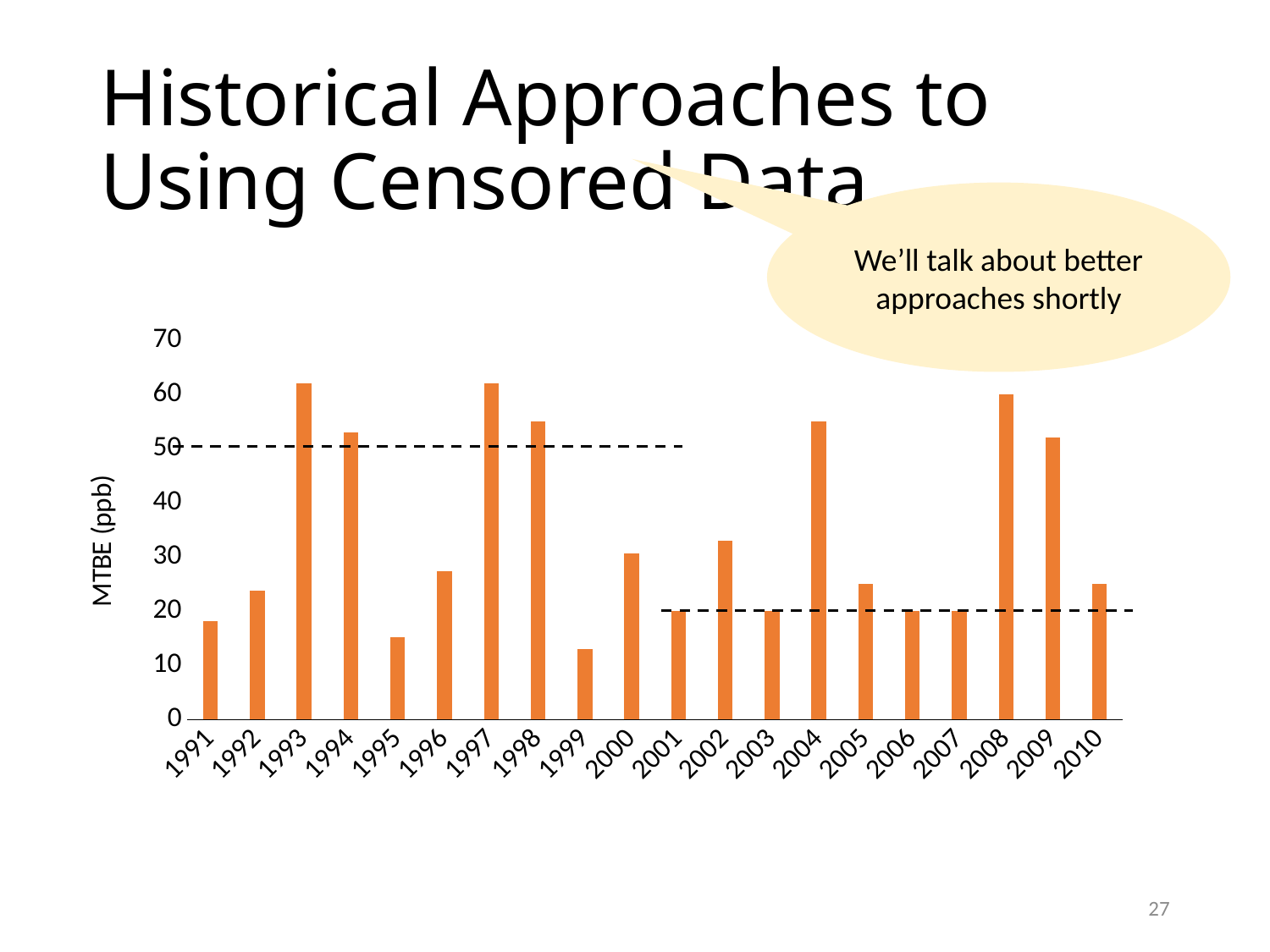
Is the value for 2000 greater or less than 20? greater Is the value for 1993 greater or less than 50? greater Which year has the larger value, 1992 or 1993? 1993 Is the value for 1999 greater or less than 20? less How many years are shown on the x axis of the chart? 20 Which year has the larger value, 2004 or 2005? 2004 What kind of chart is shown on the slide? bar chart Which year has the larger value, 1998 or 1999? 1998 What is the label of the vertical axis of the chart? MTBE (ppb)